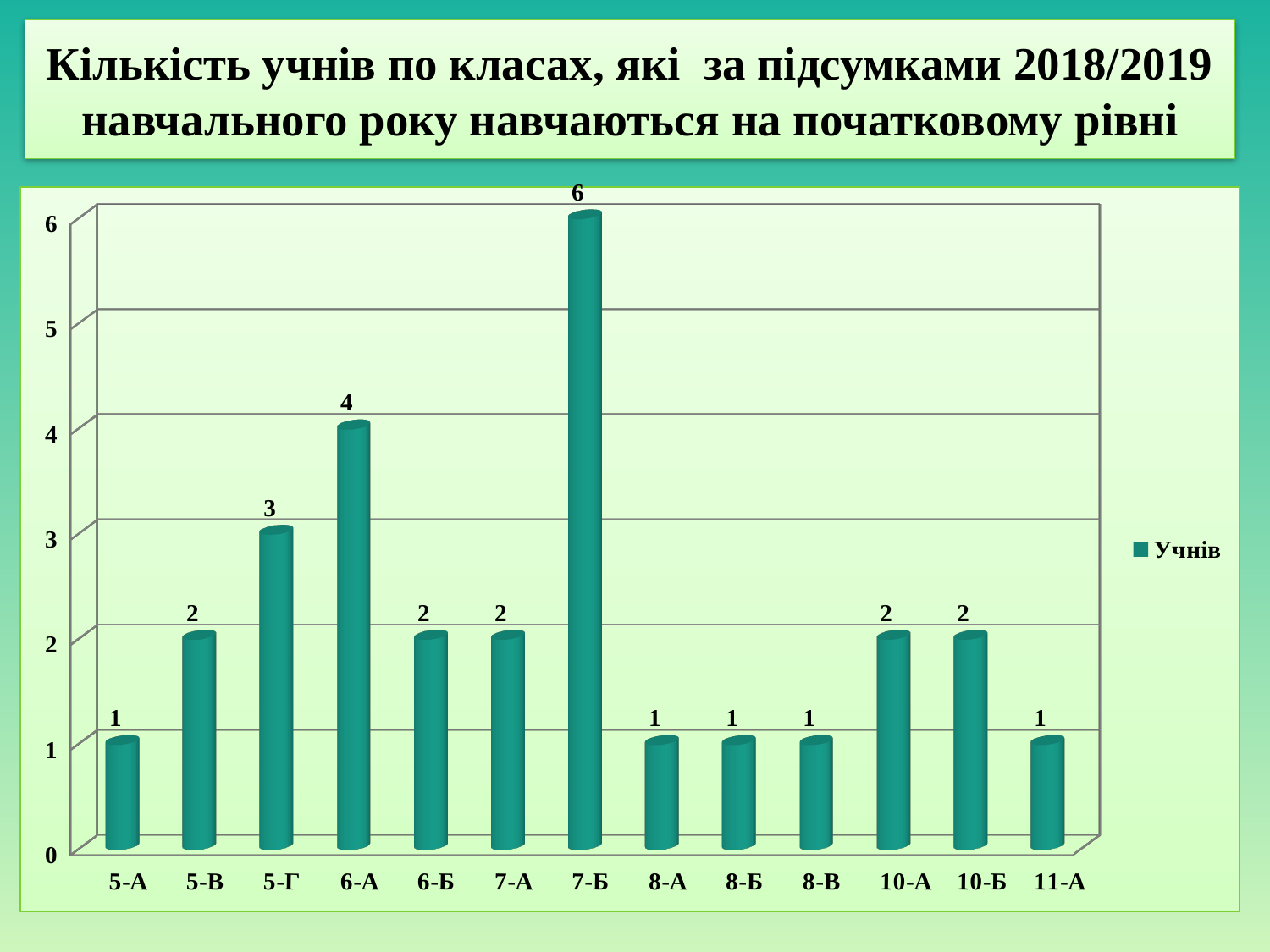
Which class has the highest value? 7-Б What is the difference between the values for 7-Б and 6-А? 2 What is the difference between the values for 5-Г and 5-А? 2 What is the value for 7-Б? 6 Which is larger, the value for 6-А or the value for 10-А? 6-А What kind of chart is shown? bar chart What is the legend entry for the series? Учнів What is the value for 5-Г? 3 What is the value for 6-А? 4 How many series does the legend list? 1 How many classes are shown on the x axis? 13 Is the value for 7-Б greater or less than 5? greater